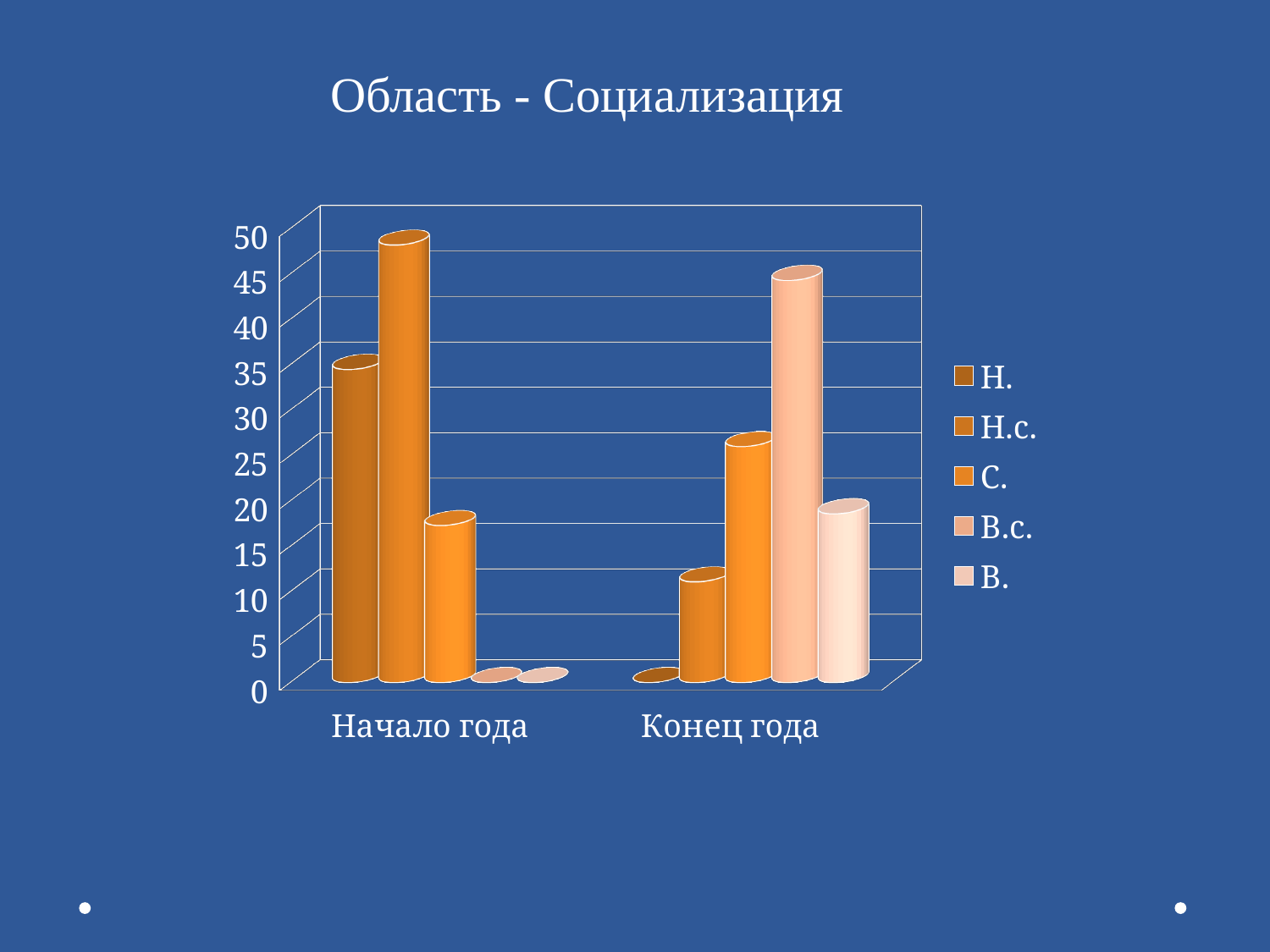
Is the value of С. for Начало года greater or less than 25? less How many series does the legend list? 5 Which series has the highest value for Конец года? В.с. What is the title of the slide? Область - Социализация Does the value of В.с. rise or fall from Начало года to Конец года? rise Which is larger: the value of Н. for Начало года or for Конец года? Начало года How many categories are shown on the x axis? 2 What kind of chart is shown on the slide? bar chart Is the value of В.с. for Конец года greater or less than 35? greater Is the value of Н.с. for Конец года greater or less than 20? less Which series has the highest value for Начало года? Н.с.